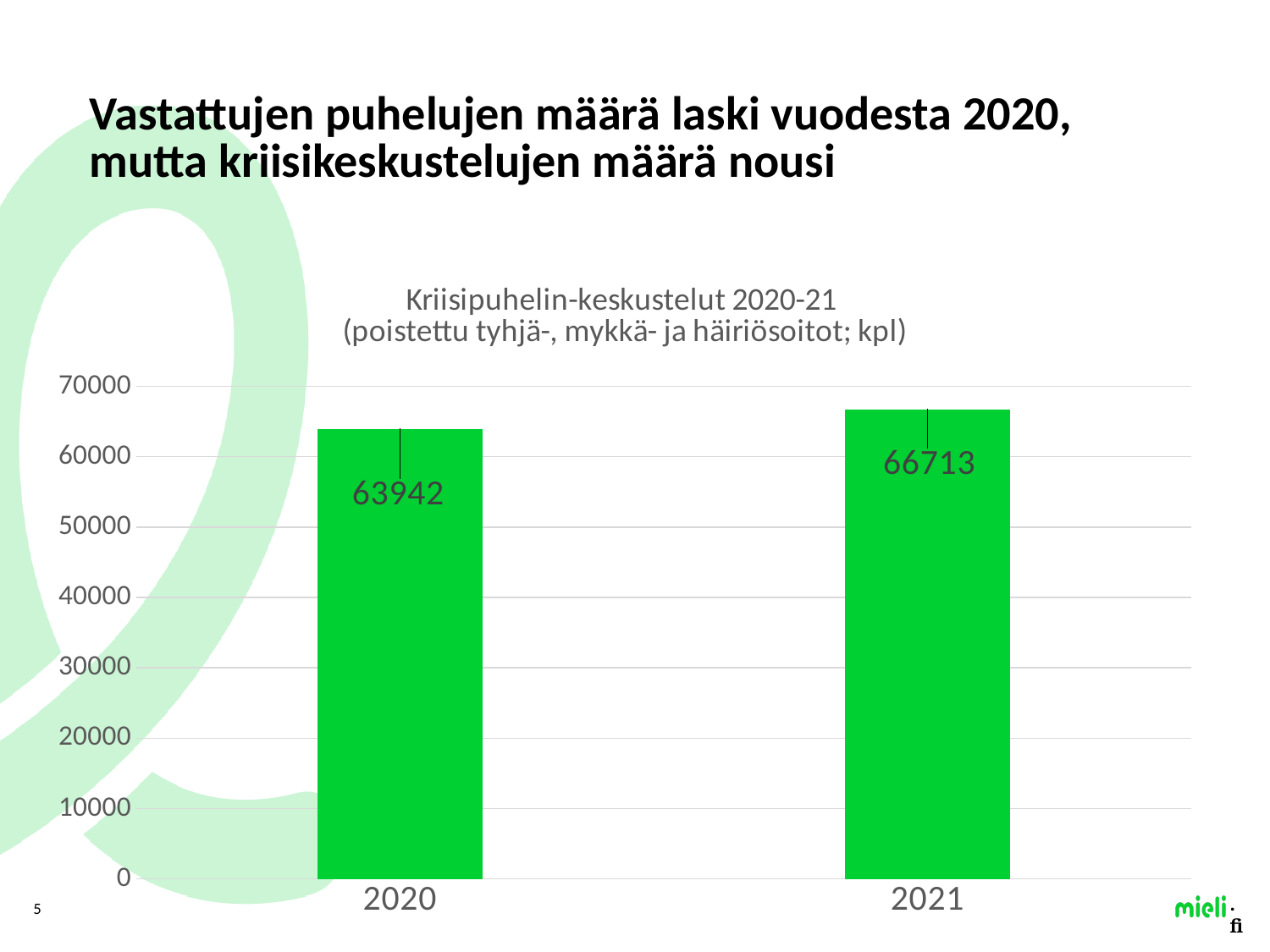
Which year has the lower value? 2020 How many years are shown on the chart? 2 What kind of chart is shown on the slide? Bar chart Is the value for 2021 larger than the value for 2020? Yes What is the value for 2021? 66713 Is the value for 2021 greater or less than 70000? less What is the value for 2020? 63942 Do the values rise or fall from 2020 to 2021? Rise What is the difference between the values for 2021 and 2020? 2771 Which year has the higher value? 2021 Is the value for 2020 greater or less than 60000? greater What is the title of the chart? Kriisipuhelin-keskustelut 2020-21 (poistettu tyhjä-, mykkä- ja häiriösoitot; kpl)